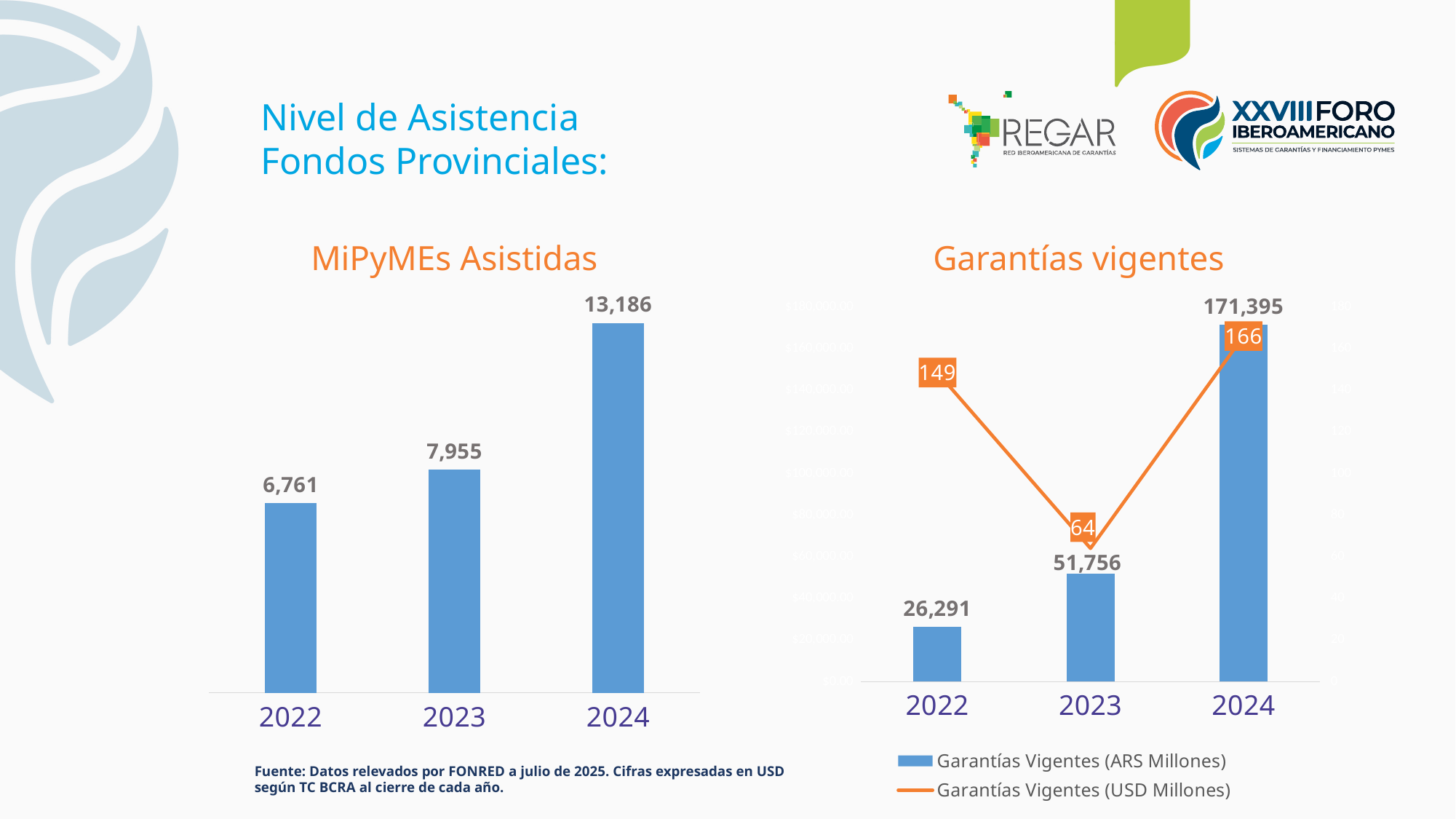
In the 'MiPyMEs Asistidas' chart, which year has the highest value? 2024 In the 'MiPyMEs Asistidas' chart, do the values rise or fall from 2022 to 2024? rise How many series does the legend of the 'Garantías vigentes' chart list? 2 What kind of chart is the 'MiPyMEs Asistidas' chart? bar chart In the 'MiPyMEs Asistidas' chart, what is the difference between the 2024 and 2022 values? 6,425 In the 'Garantías vigentes' chart, which is larger: Garantías Vigentes (USD Millones) in 2022 or in 2024? 2024 In the 'Garantías vigentes' chart, which year has the lowest value of Garantías Vigentes (USD Millones)? 2023 In the 'Garantías vigentes' chart, how many years are shown on the x axis? 3 In the 'Garantías vigentes' chart, what is the value of Garantías Vigentes (ARS Millones) for 2022? 26,291 In the 'Garantías vigentes' chart, what is the value of Garantías Vigentes (USD Millones) for 2023? 64 In the 'MiPyMEs Asistidas' chart, what is the value for 2023? 7,955 In the 'Garantías vigentes' chart, what is the difference between the Garantías Vigentes (ARS Millones) values for 2024 and 2023? 119,639